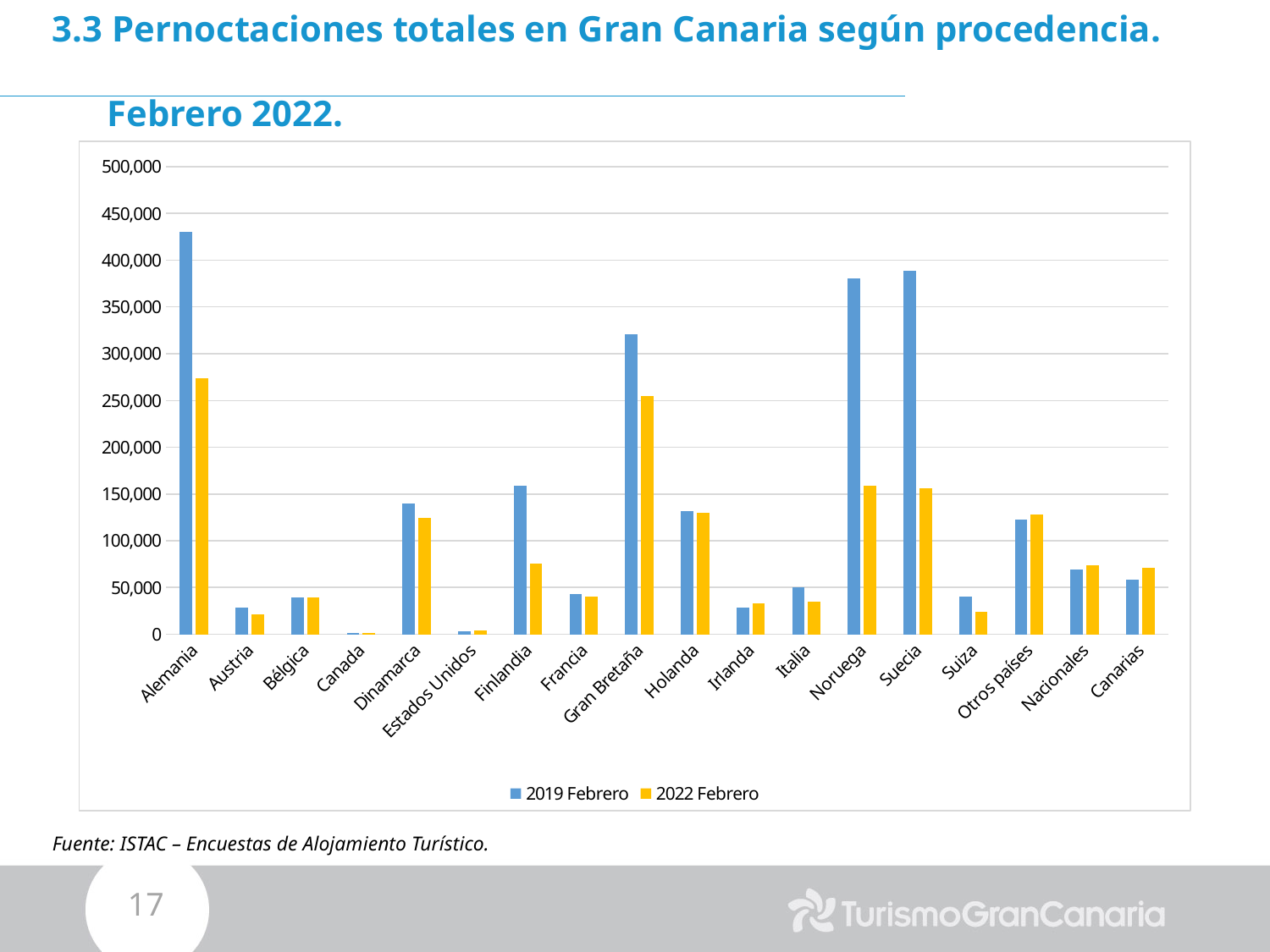
Is the 2022 Febrero value for Alemania greater or less than 300,000? less What kind of chart is shown on the slide? bar chart Is the 2022 Febrero value for Noruega greater or less than 200,000? less Which category has the highest value for 2022 Febrero? Alemania Is the 2019 Febrero value for Gran Bretaña greater or less than 300,000? greater For Canarias, which series has the larger value, 2019 Febrero or 2022 Febrero? 2022 Febrero For Finlandia, which series has the larger value, 2019 Febrero or 2022 Febrero? 2019 Febrero Which category has the highest value for 2019 Febrero? Alemania What are the two legend entries of the chart? 2019 Febrero and 2022 Febrero How many countries/categories are shown on the x axis? 18 How many series does the legend list? 2